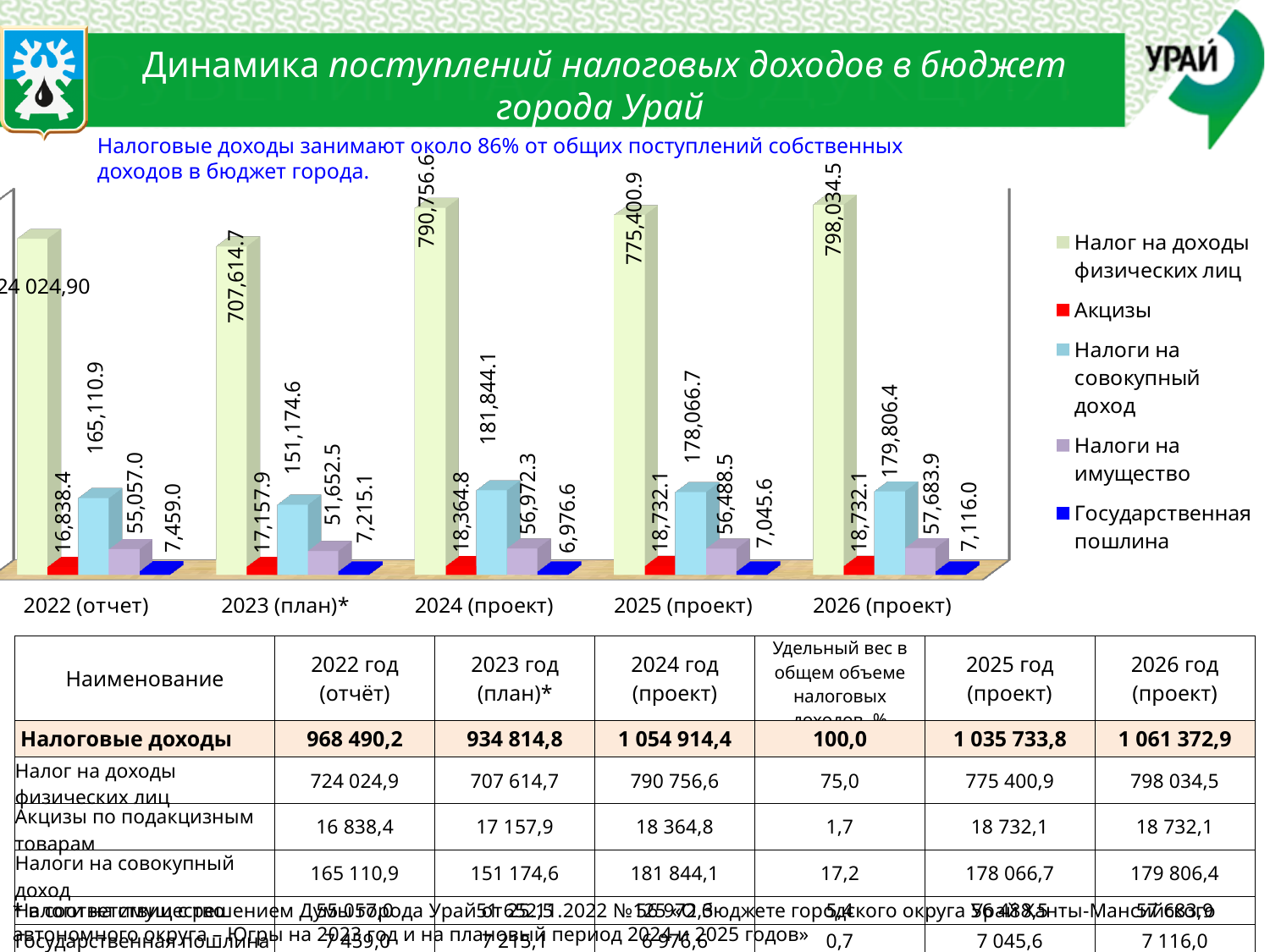
By how much does Акцизы in 2024 (проект) exceed Акцизы in 2023 (план)*? 1,206.9 What is the value for Государственная пошлина in 2026 (проект)? 7,116.0 How many series does the chart legend list? 5 In which year is Налог на доходы физических лиц highest? 2026 (проект) What is the value for Налоги на имущество in 2022 (отчет)? 55,057.0 What is the value for Налог на доходы физических лиц in 2024 (проект)? 790,756.6 What is the value for Акцизы in 2023 (план)*? 17,157.9 What is the value for Налоги на совокупный доход in 2025 (проект)? 178,066.7 How many years (categories) are shown on the x axis of the chart? 5 Which is larger: Налоги на имущество in 2025 (проект) or in 2026 (проект)? 2026 (проект) What kind of chart is shown on the slide? bar chart In which year is Налоги на совокупный доход lowest? 2023 (план)*